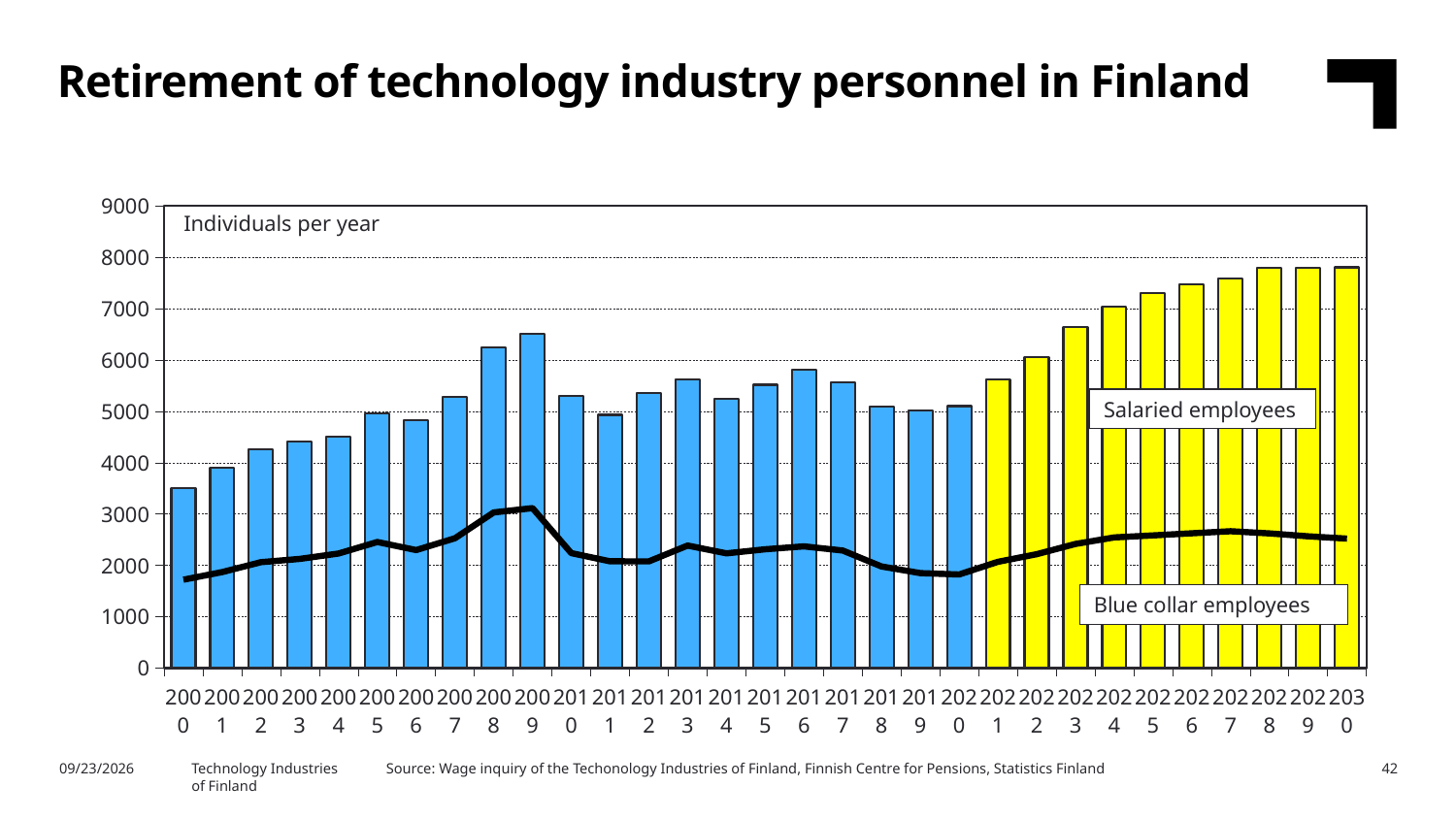
Which year has the lowest bar in the chart? 2000 Is the bar value for 2000 greater or less than 4000? less Which year has the larger bar, 2009 or 2010? 2009 Is the bar value for 2009 greater or less than 6000? greater Among the blue bars (2000 to 2020), which year has the highest bar? 2009 What kind of chart is shown on the slide? Bar chart with a line Is the black line value for 2000 greater or less than 2000? less How many years are shown along the x axis of the chart? 31 What unit label is printed inside the plot area of the chart? Individuals per year What colour are the bars for the years 2021 to 2030? Yellow Do the bar values rise or fall from 2021 to 2030? Rise